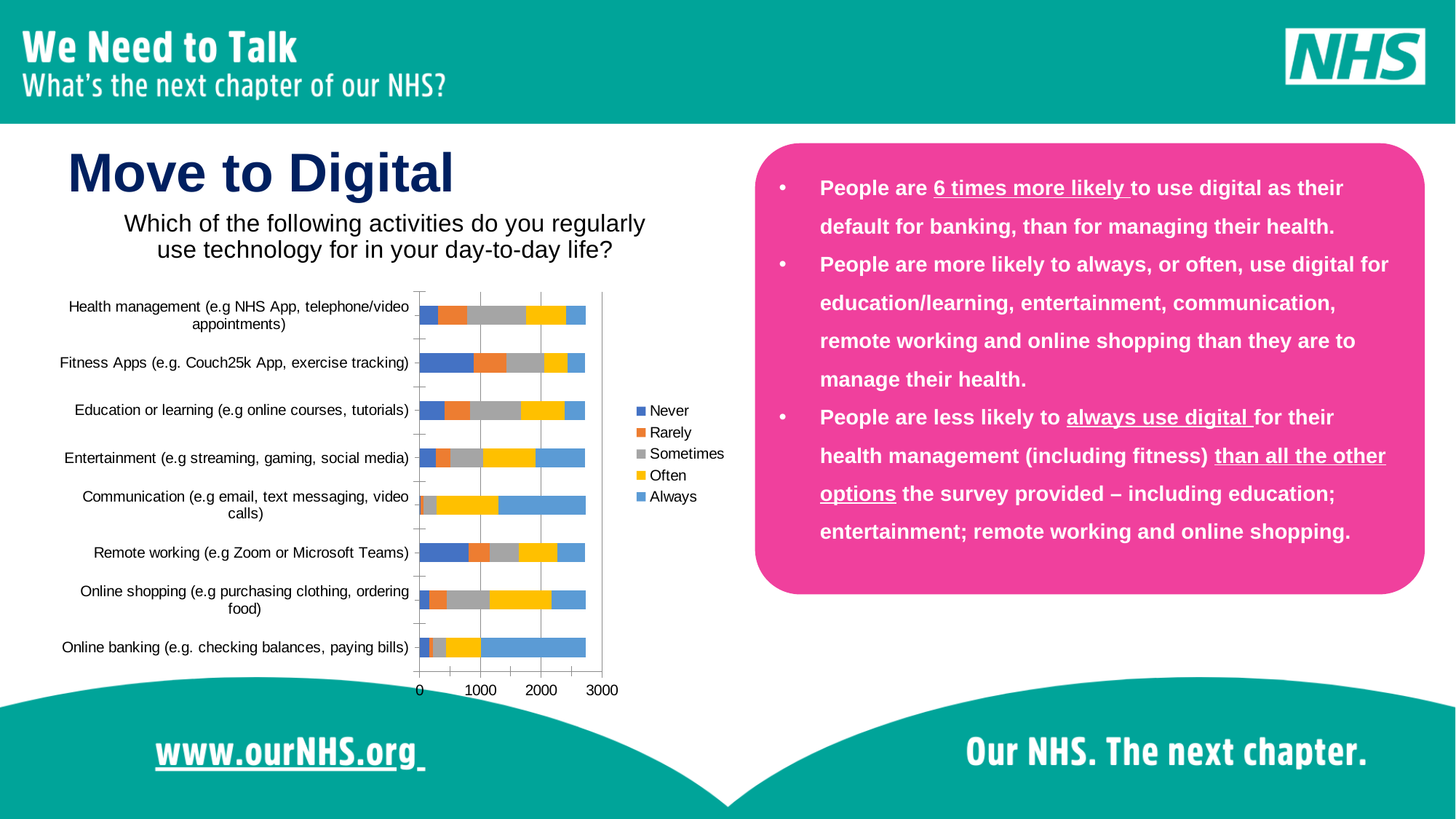
Which activity has the largest 'Always' segment? Online banking (e.g. checking balances, paying bills) How many activity categories are plotted on the chart? 8 Is the total bar length for Online banking greater or less than 2000? greater What question is the chart titled with? Which of the following activities do you regularly use technology for in your day-to-day life? Is the 'Never' segment larger for Remote working or for Communication? Remote working What are the five response options listed in the chart's legend? Never, Rarely, Sometimes, Often, Always How many series does the chart's legend list? 5 What kind of chart is shown on the slide? Stacked bar chart Is the 'Always' segment larger for Online banking or for Health management? Online banking Which activity has the largest 'Never' segment? Fitness Apps (e.g. Couch25k App, exercise tracking) Is the total bar length for Health management greater or less than 3000? less